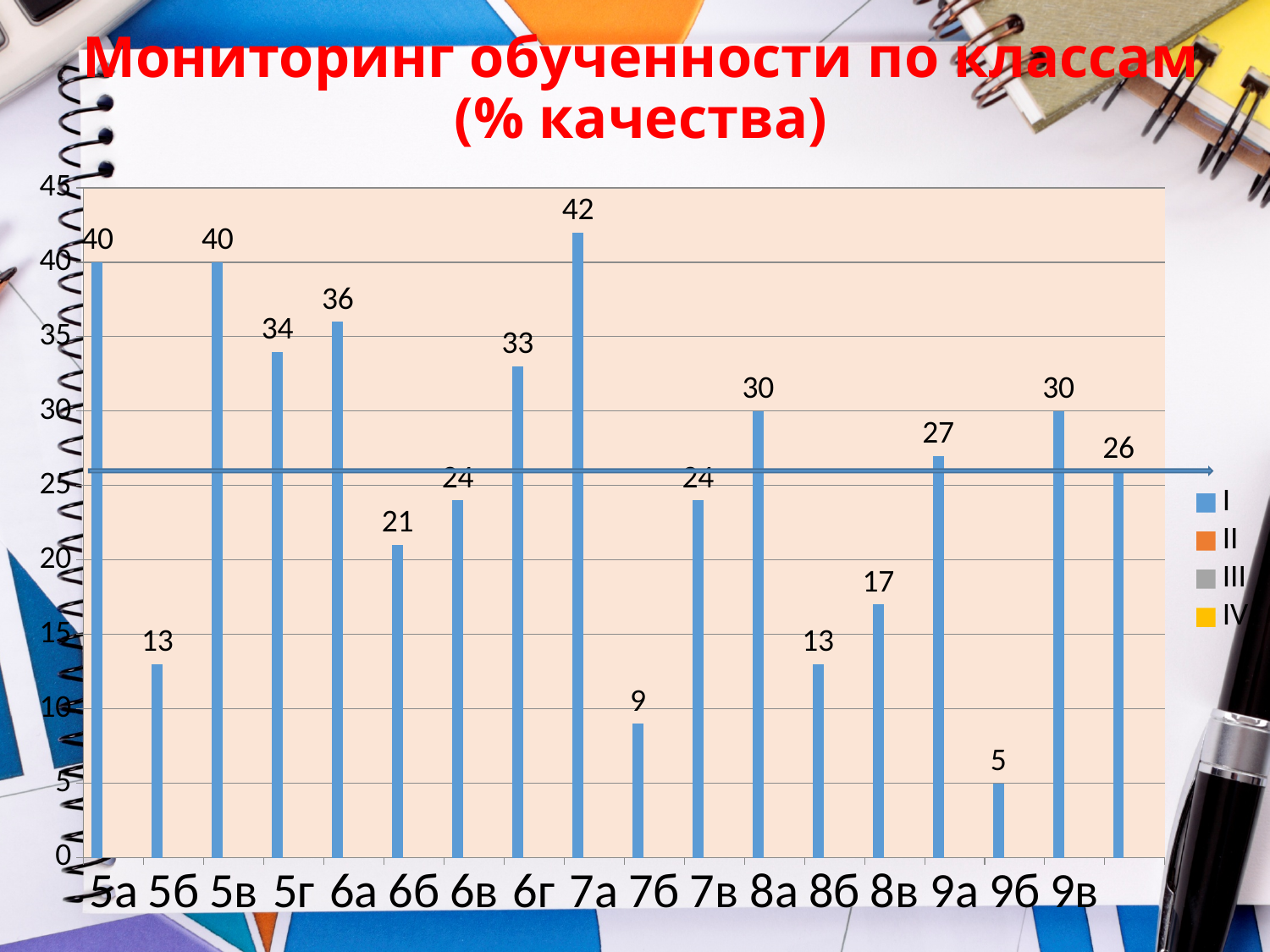
Which class has the lowest value? 9б What is the value for class 8в? 17 How many classes are shown on the x axis? 17 What is the title of the chart? Мониторинг обученности по классам (% качества) What is the value for class 7а? 42 What kind of chart is shown on the slide? bar chart What is the difference between the values for 5а and 5б? 27 Which class has the highest value? 7а What is the difference between the values for 7а and 7б? 33 What is the value for class 9б? 5 How many series does the legend list? 4 Which is larger, the value for 5г or the value for 6а? 6а